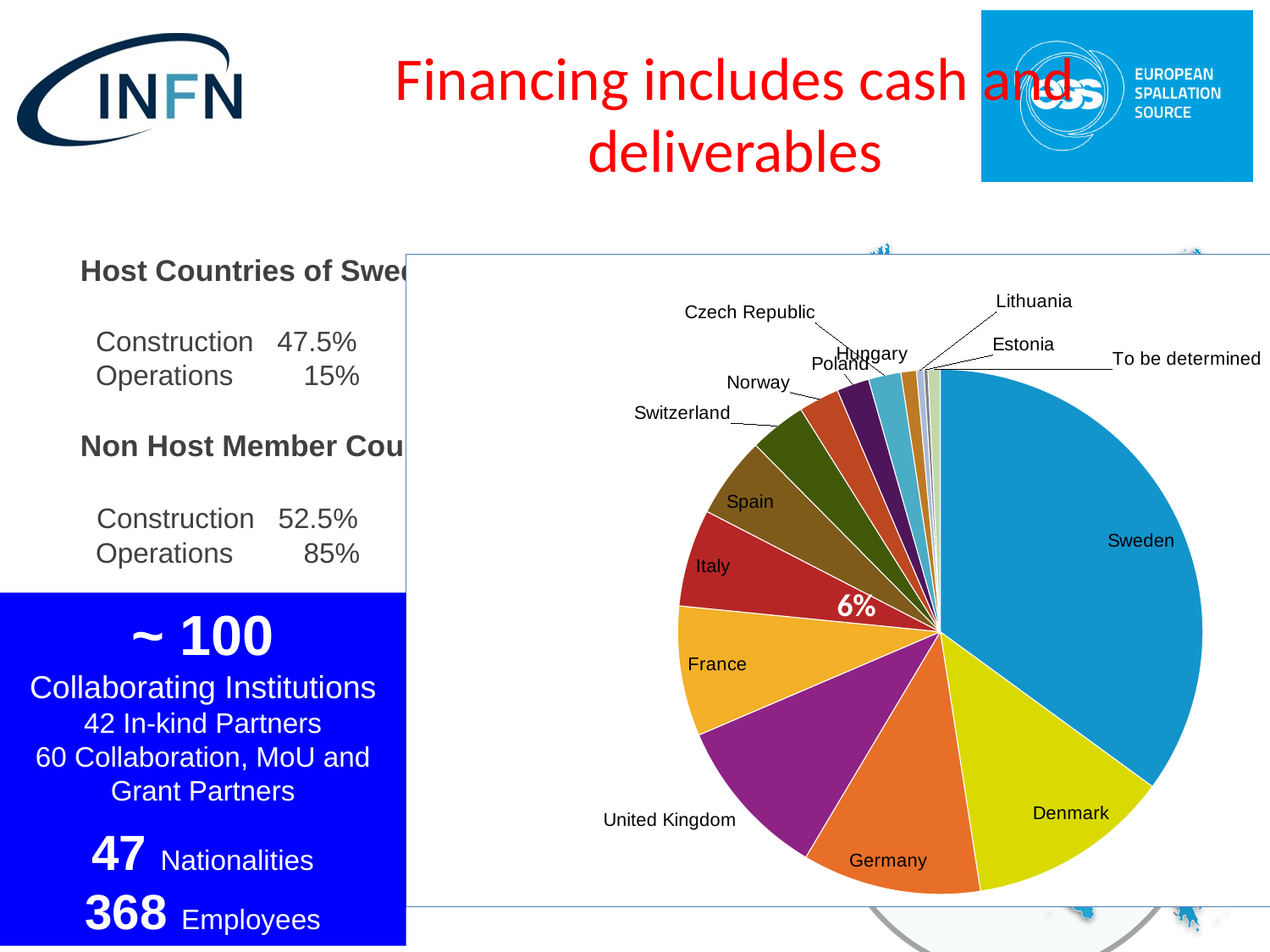
Which slice is larger in the pie chart, United Kingdom or Spain? United Kingdom Which country has the largest slice of the pie chart? Sweden Which slice is larger in the pie chart, Denmark or Italy? Denmark What is the label of the slice that is not assigned to a specific country in the pie chart? To be determined Which slice is larger in the pie chart, France or Norway? France How many slices does the pie chart have? 15 What percentage is printed on the Italy slice of the pie chart? 6% What kind of chart is shown on the slide? pie chart What colour is the Sweden slice in the pie chart? blue